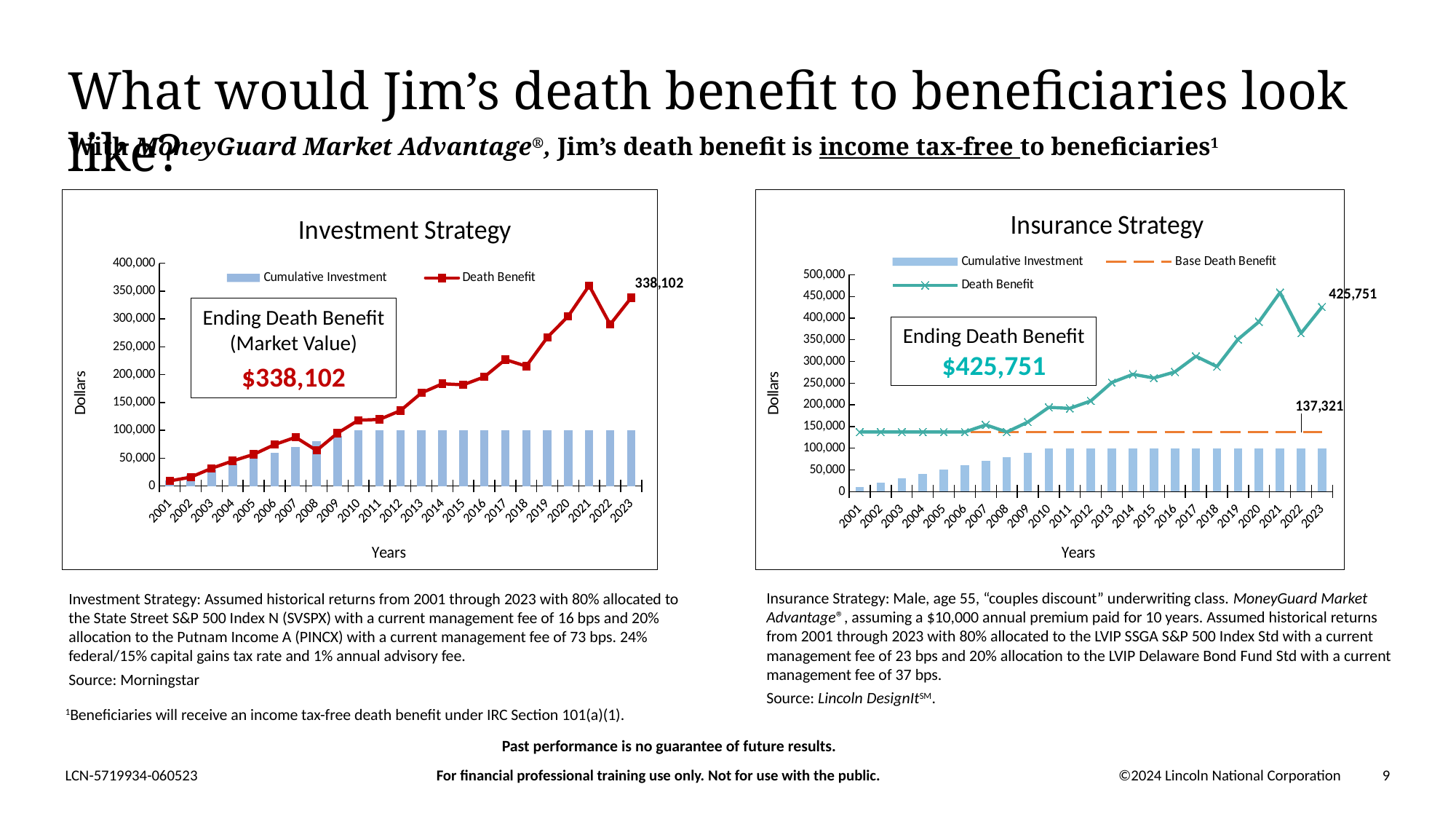
How many series does the legend of the Insurance Strategy chart list? 3 On the Investment Strategy chart, does the Death Benefit line generally rise or fall from 2001 to 2023? Rise On the Insurance Strategy chart, in which year does the Death Benefit line reach its highest point? 2021 On the Insurance Strategy chart, what value is labelled for the Base Death Benefit line? 137,321 What kind of chart is the Insurance Strategy chart? Combination bar and line chart Which chart shows the larger ending death benefit in 2023, Investment Strategy or Insurance Strategy? Insurance Strategy On the Insurance Strategy chart, what is the Death Benefit value labelled for 2023? 425,751 On the Investment Strategy chart, what is the Death Benefit value labelled for 2023? 338,102 How many series does the legend of the Investment Strategy chart list? 2 On the Investment Strategy chart, is the Death Benefit value for 2010 greater or less than 100,000? greater How many years are shown on the x axis of the Investment Strategy chart? 23 What is the difference between the ending death benefit on the Insurance Strategy chart (425,751) and the ending death benefit on the Investment Strategy chart (338,102)? 87,649